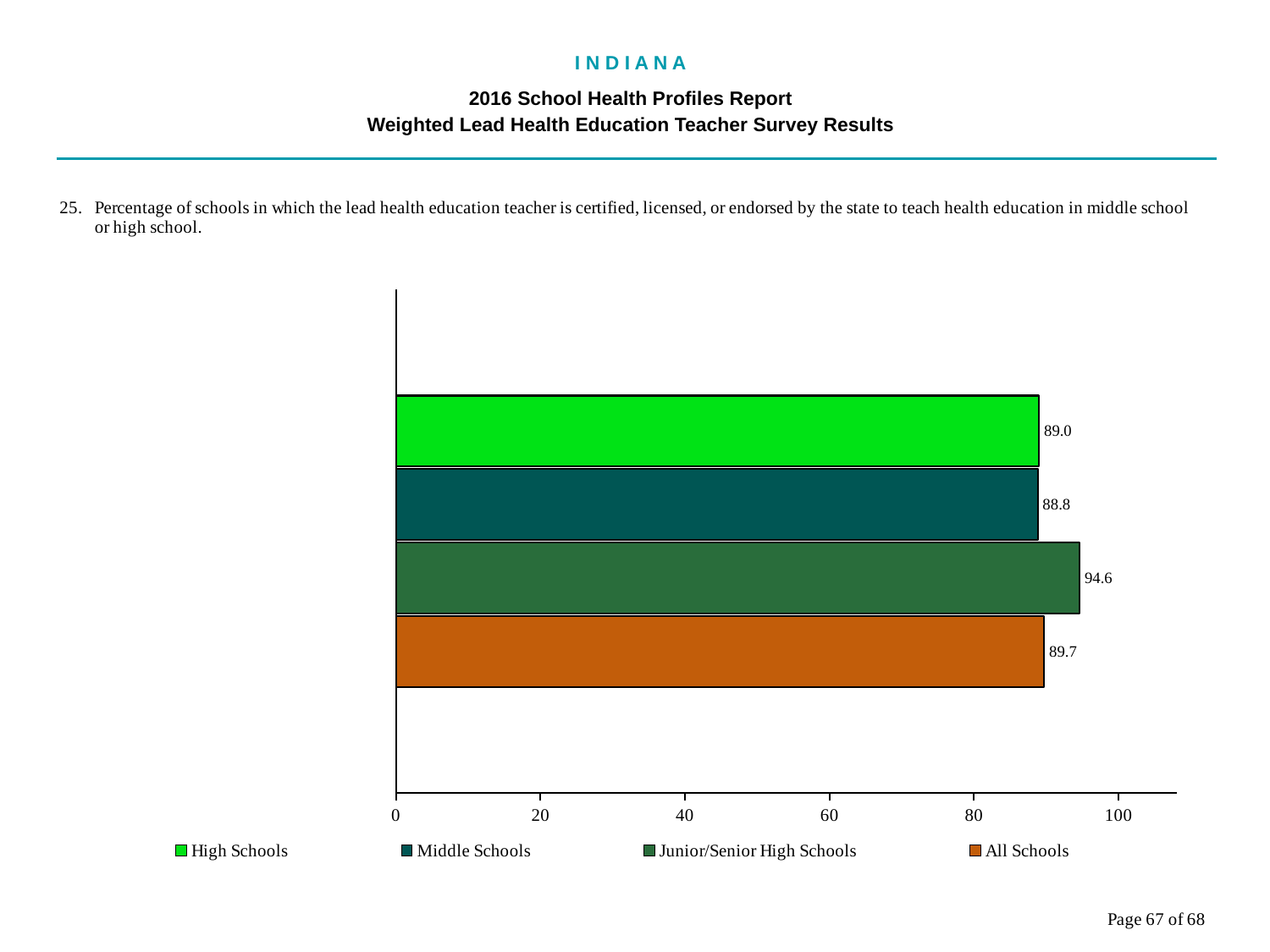
What is the difference between the values for All Schools and High Schools? 0.7 Which category has the highest value? Junior/Senior High Schools How many entries does the legend list? 4 What kind of chart is shown on the slide? bar chart How many bars are plotted in the chart? 4 What is the value for Junior/Senior High Schools? 94.6 What is the value for All Schools? 89.7 Which is larger, the value for Junior/Senior High Schools or the value for All Schools? Junior/Senior High Schools What is the difference between the values for Junior/Senior High Schools and Middle Schools? 5.8 What is the value for Middle Schools? 88.8 What is the value for High Schools? 89.0 Is the value for Middle Schools greater or less than 80? greater